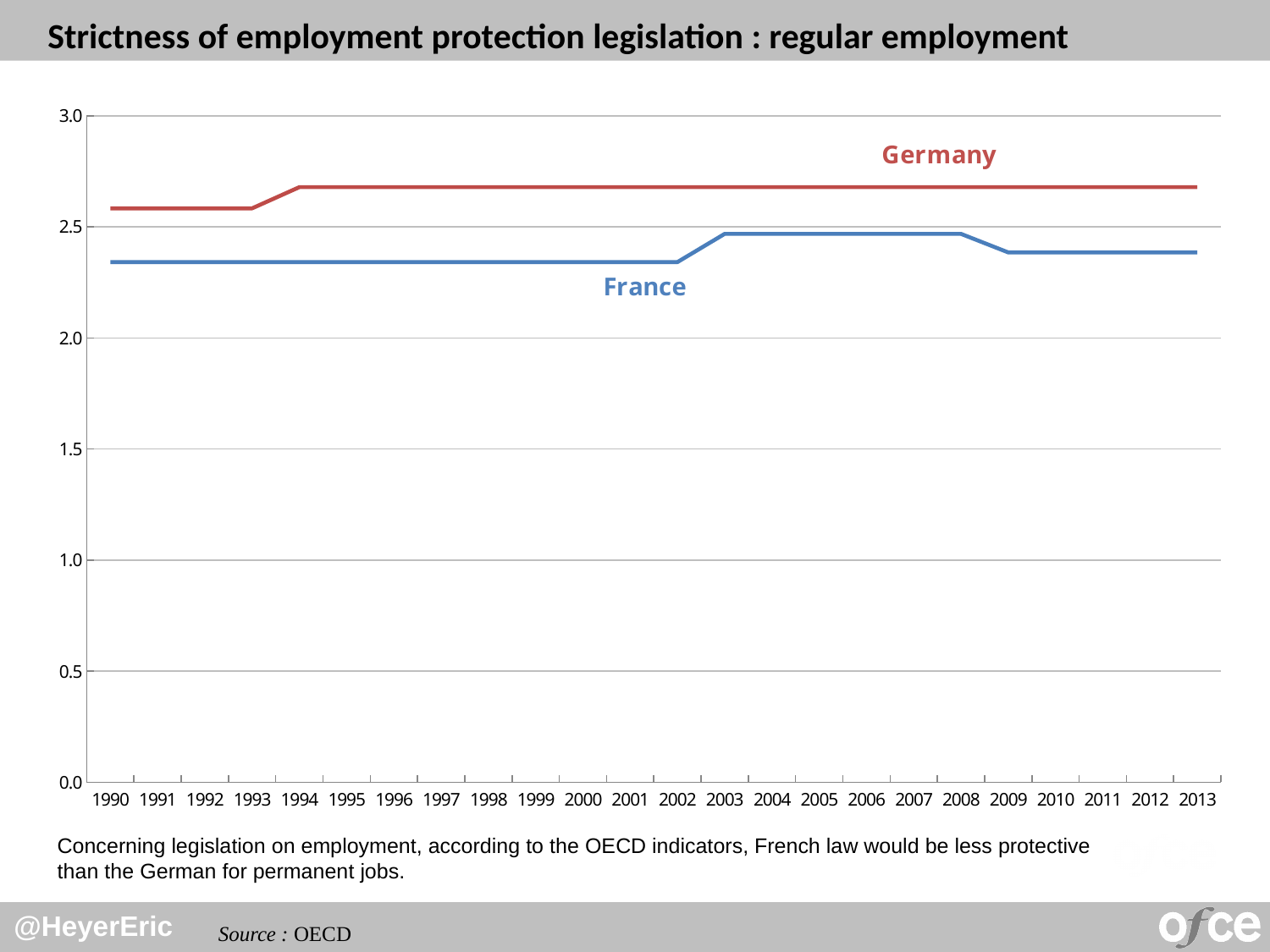
Is the value for Germany in 2013 greater or less than 2.5? greater What kind of chart is shown on the slide? line chart How many years are shown on the x axis of the chart? 24 Is the value for France in 1990 greater or less than 2.5? less Does the Germany line rise or fall between 1993 and 1994? rise Which series has the higher values across the whole period? Germany How many series are plotted on the chart? 2 Does the France line rise or fall between 2008 and 2009? fall Which country has the higher value in 2013, Germany or France? Germany What colour is the line for Germany? red What is the title of the chart? Strictness of employment protection legislation : regular employment Is the value for France in 2000 greater or less than 2.0? greater